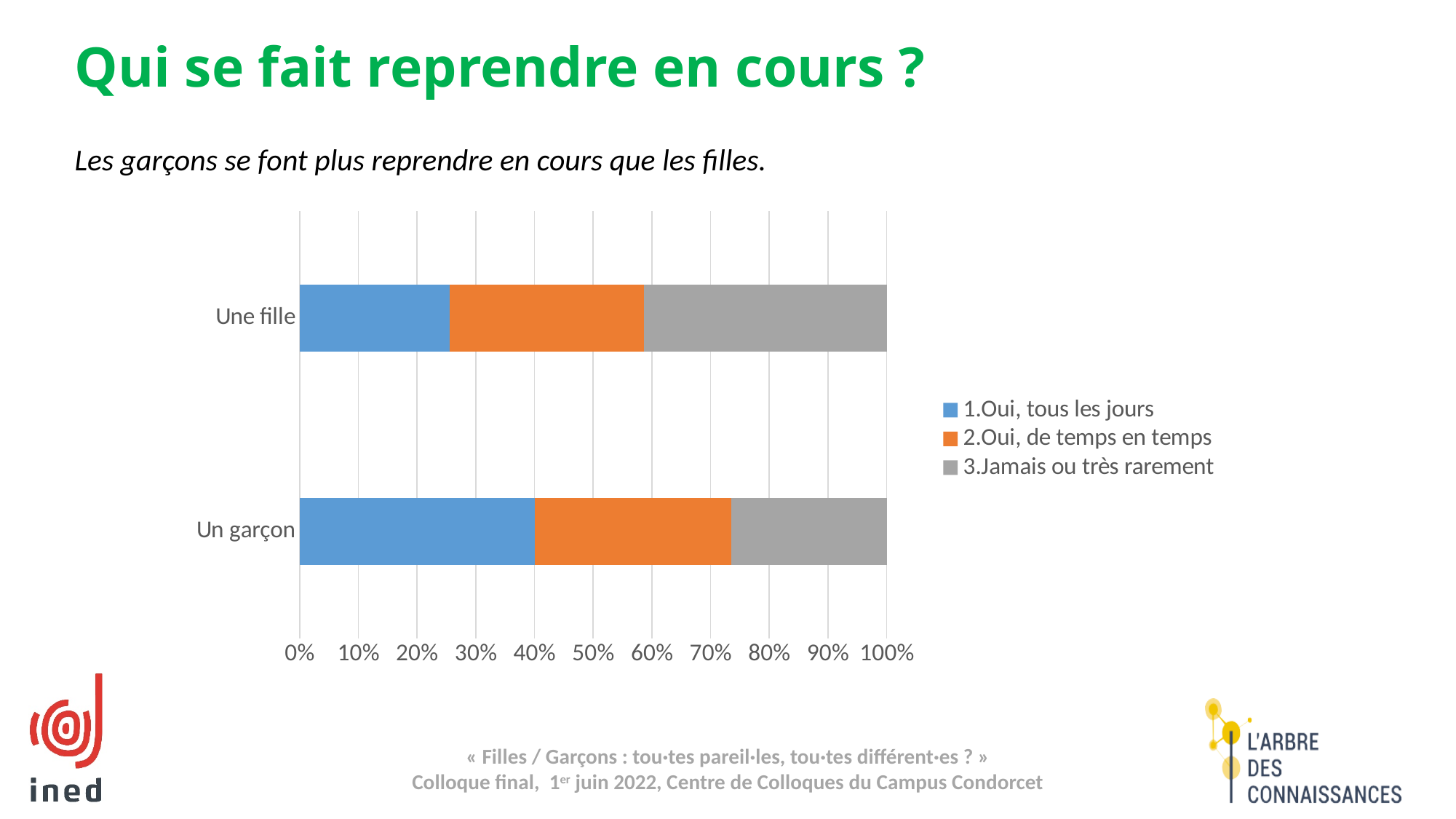
Is the "1.Oui, tous les jours" value for "Une fille" greater or less than 30%? less Which colour represents "2.Oui, de temps en temps" in the chart's legend? orange Is the "1.Oui, tous les jours" value for "Un garçon" greater or less than 30%? greater Which category has the larger "1.Oui, tous les jours" share, "Une fille" or "Un garçon"? Un garçon What is the total of the stacked bar for "Un garçon"? 100% How many categories are plotted on the y axis of the chart? 2 How many series does the chart's legend list? 3 Is the "3.Jamais ou très rarement" value for "Un garçon" greater or less than 40%? less Which category has the larger "3.Jamais ou très rarement" share, "Une fille" or "Un garçon"? Une fille What is the title of the slide containing the chart? Qui se fait reprendre en cours ? What kind of chart is shown on the slide? bar chart